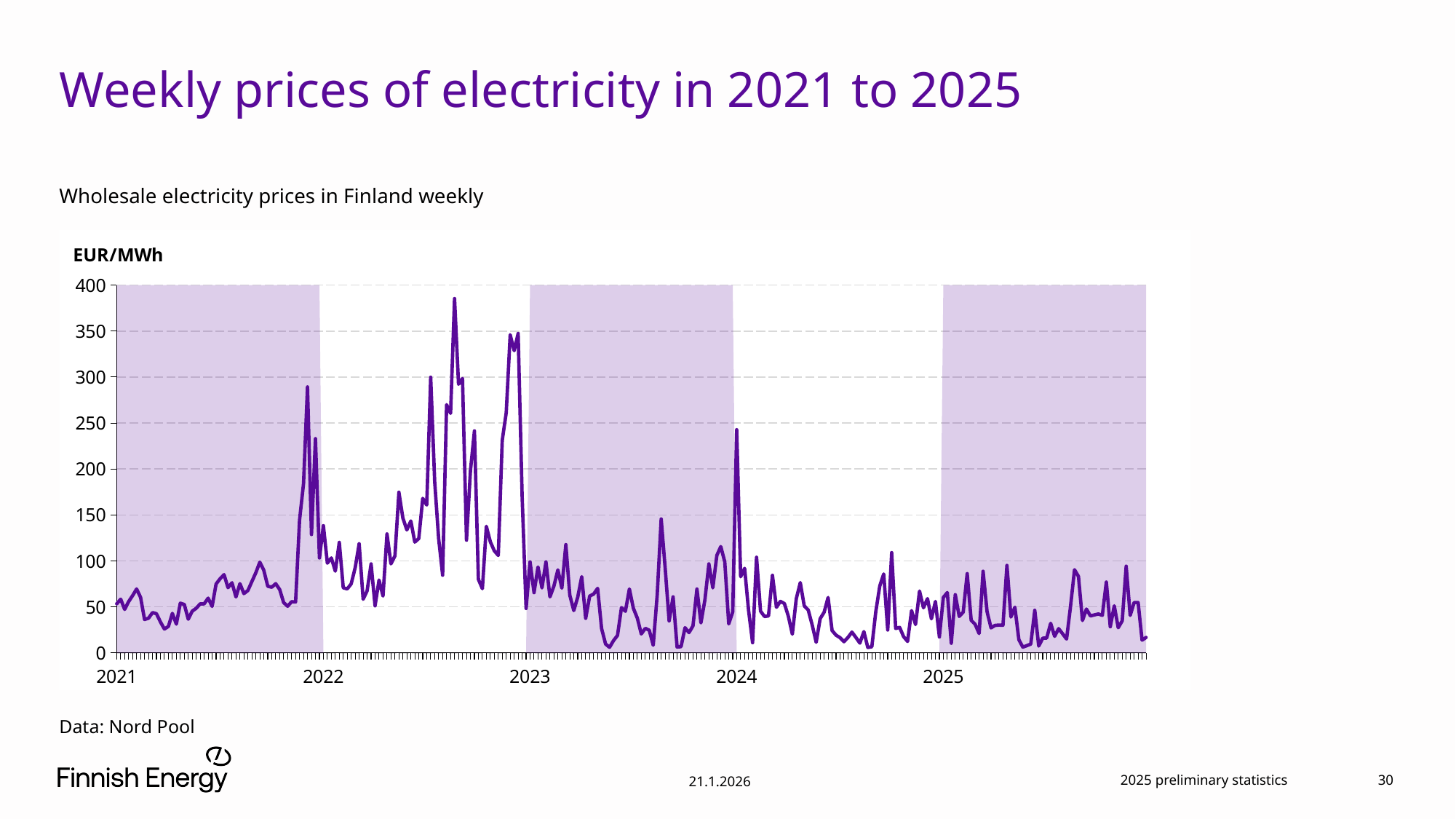
Is the highest peak of the weekly price greater or less than 350 EUR/MWh? greater What is the highest value shown on the y axis? 400 Is the price spike at the start of 2024 greater or less than 200 EUR/MWh? greater What kind of chart is shown on the slide? line chart At the start of 2021, is the weekly price greater or less than 100 EUR/MWh? less How many year labels are shown on the x axis? 5 Do weekly prices generally rise or fall from 2022 to 2025? fall What unit is shown on the y axis of the chart? EUR/MWh What is the data source cited below the chart? Nord Pool In which year does the weekly electricity price reach its highest peak? 2022